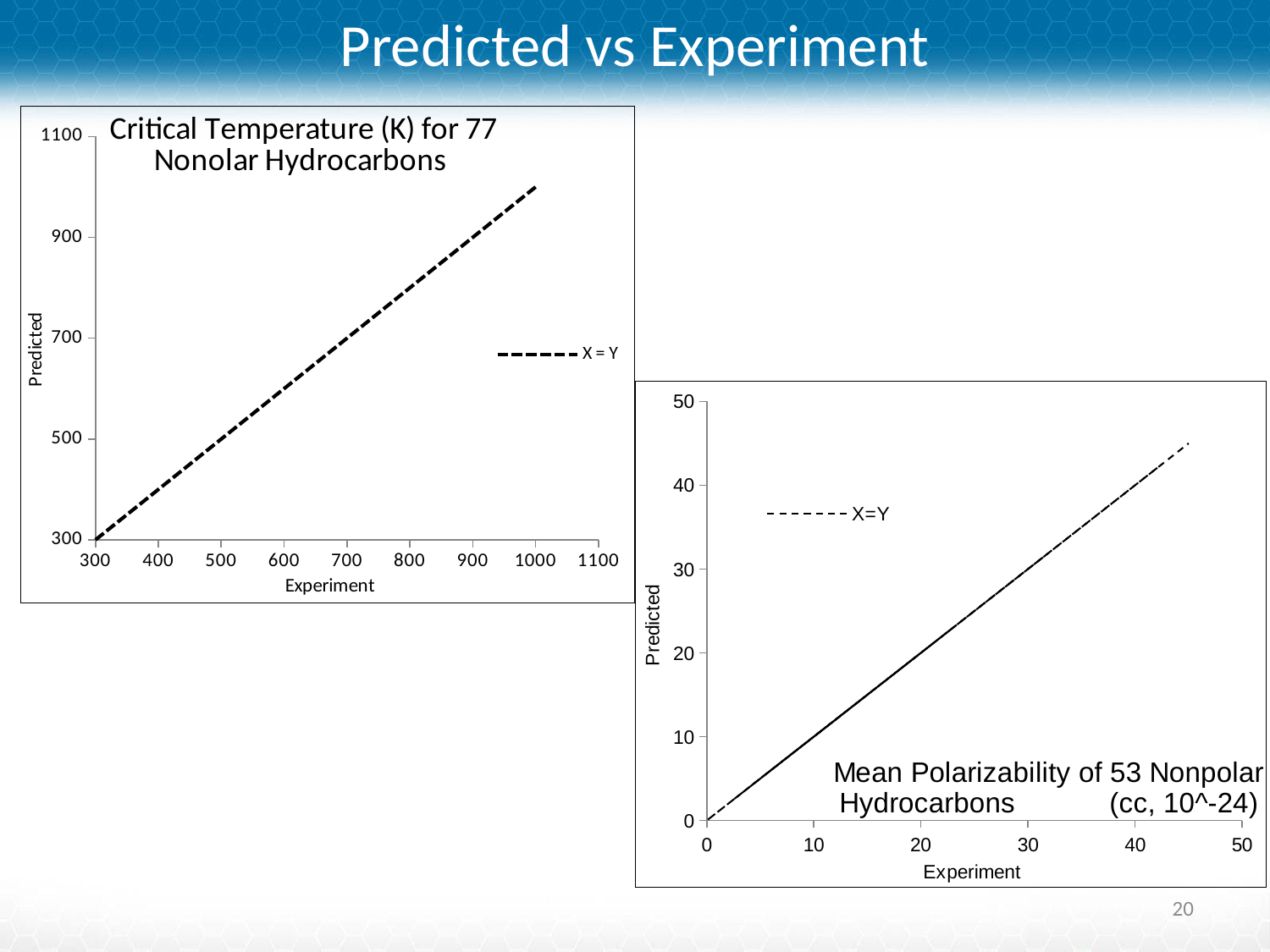
What is the x-axis title on the right chart, 'Mean Polarizability of 53 Nonpolar Hydrocarbons'? Experiment How many series does the legend list on the left chart, 'Critical Temperature (K) for 77 Nonolar Hydrocarbons'? 1 On the left chart, 'Critical Temperature (K) for 77 Nonolar Hydrocarbons', does the plotted line rise or fall as Experiment increases? rise On the right chart, 'Mean Polarizability of 53 Nonpolar Hydrocarbons', is the Predicted value of the line at Experiment 40 greater or less than 30? greater What kind of chart is the 'Mean Polarizability of 53 Nonpolar Hydrocarbons' chart on the right? line chart On the left chart, 'Critical Temperature (K) for 77 Nonolar Hydrocarbons', is the Predicted value of the line at Experiment 900 greater or less than 700? greater On the right chart, 'Mean Polarizability of 53 Nonpolar Hydrocarbons', is the Predicted value of the line at Experiment 10 greater or less than 20? less On the right chart, 'Mean Polarizability of 53 Nonpolar Hydrocarbons', does the plotted line rise or fall as Experiment increases? rise What kind of chart is the 'Critical Temperature (K) for 77 Nonolar Hydrocarbons' chart on the left? line chart How many series does the legend list on the right chart, 'Mean Polarizability of 53 Nonpolar Hydrocarbons'? 1 What is the legend entry on the left chart, 'Critical Temperature (K) for 77 Nonolar Hydrocarbons'? X = Y